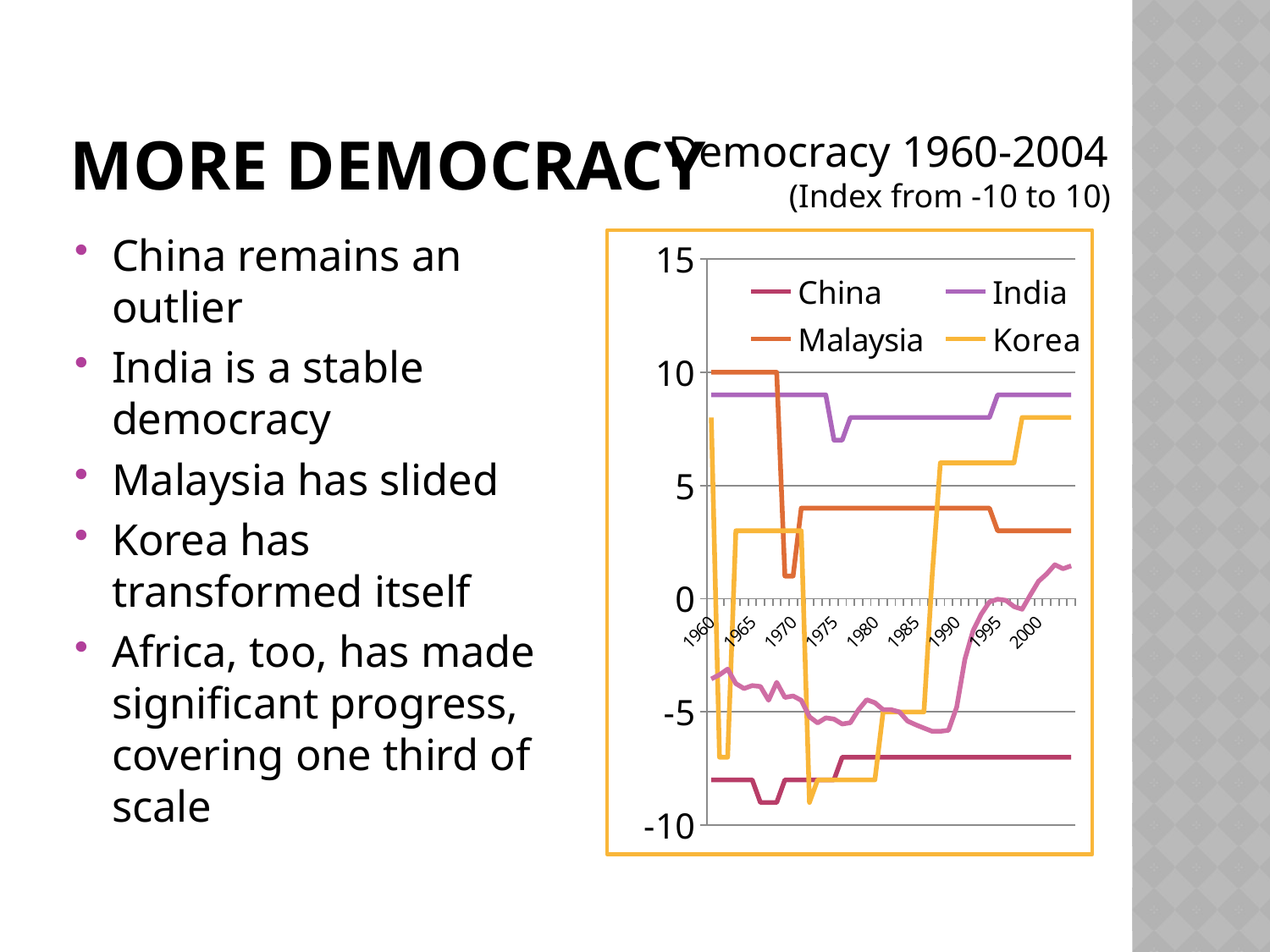
Is the value for Korea in 1985 greater or less than 0? less Is the value for Korea in 2000 greater or less than 5? greater Is the value for China in 1960 greater or less than -5? less What kind of chart is shown on the slide? line chart How many series does the chart's legend list? 4 Which series has the lowest value in 2000? China Which countries are listed in the chart's legend? China, India, Malaysia, Korea Does the Korea series rise or fall between 1990 and 2004? rise What is the title of the chart? Democracy 1960-2004 (Index from -10 to 10) In 2000, which series has the larger value, India or China? India